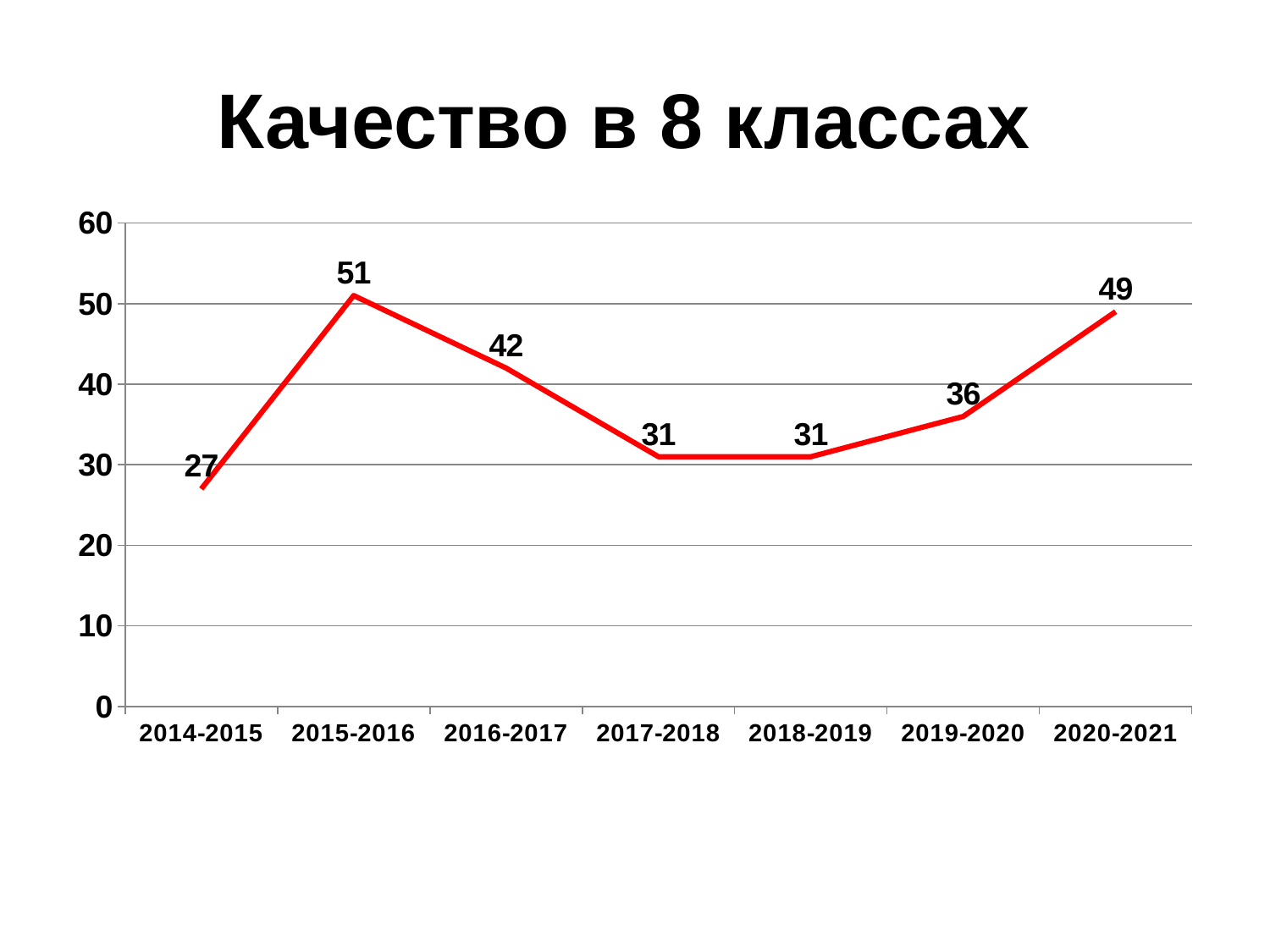
Is the value for 2017-2018 greater or less than 40? less Which year has the highest value? 2015-2016 What is the difference between the values for 2015-2016 and 2014-2015? 24 How many years are shown on the x axis? 7 What is the value for 2014-2015? 27 What is the title of the chart? Качество в 8 классах Which is larger, the value for 2016-2017 or the value for 2019-2020? 2016-2017 What is the value for 2016-2017? 42 What is the difference between the values for 2020-2021 and 2019-2020? 13 What is the value for 2020-2021? 49 Which year has the lowest value? 2014-2015 What kind of chart is this? line chart